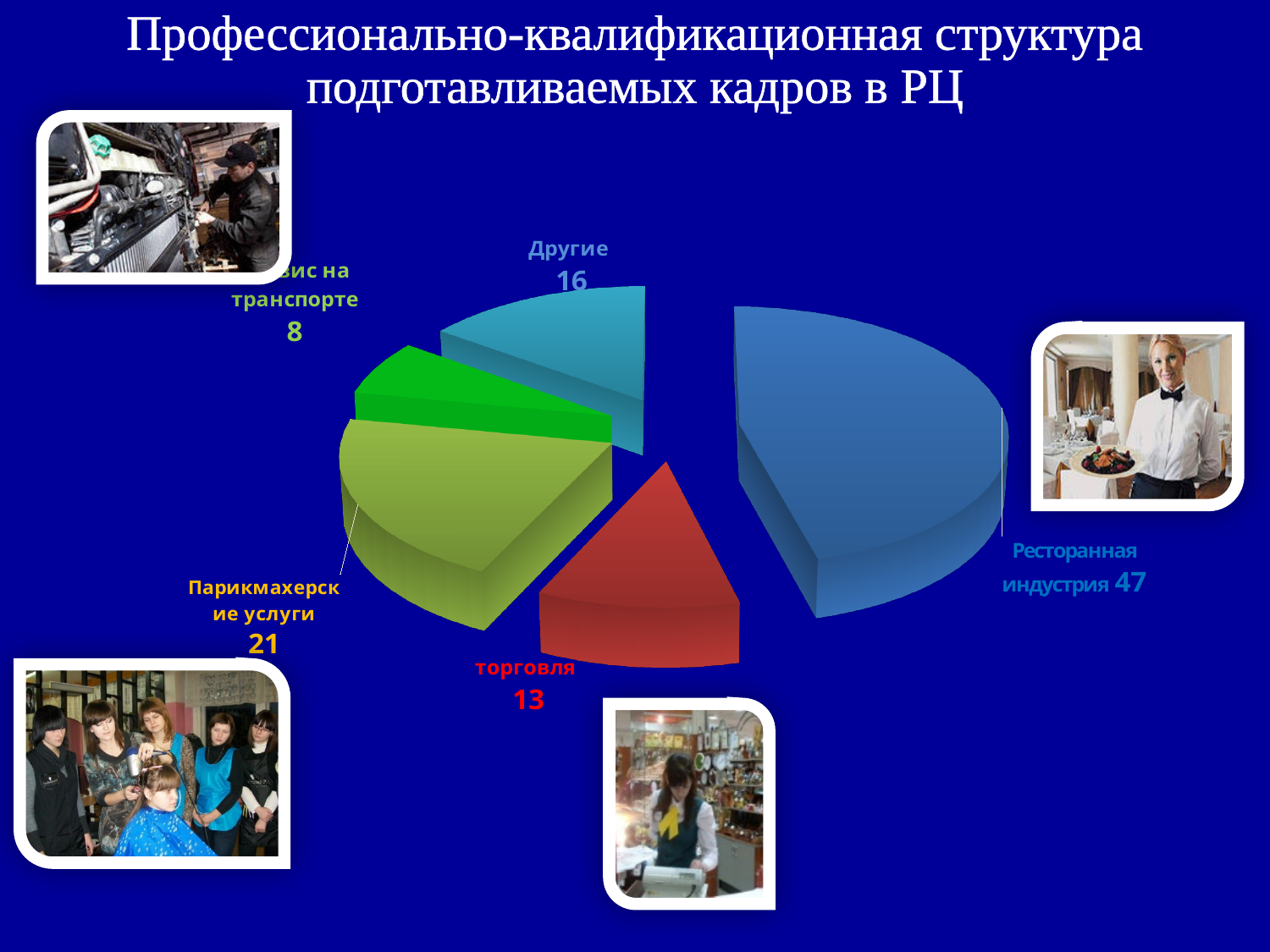
What is the value for торговля? 13 How many slices does the pie chart have? 5 What is the value for Другие? 16 What is the difference between the values for Ресторанная индустрия and Парикмахерские услуги? 26 What is the difference between the values for Другие and торговля? 3 What is the title of the slide containing the pie chart? Профессионально-квалификационная структура подготавливаемых кадров в РЦ What is the value for Парикмахерские услуги? 21 What kind of chart is shown on the slide? pie chart What colour is the торговля slice? red Which is larger, the value for Парикмахерские услуги or the value for Другие? Парикмахерские услуги What is the value for Ресторанная индустрия? 47 Which category has the largest slice of the pie? Ресторанная индустрия